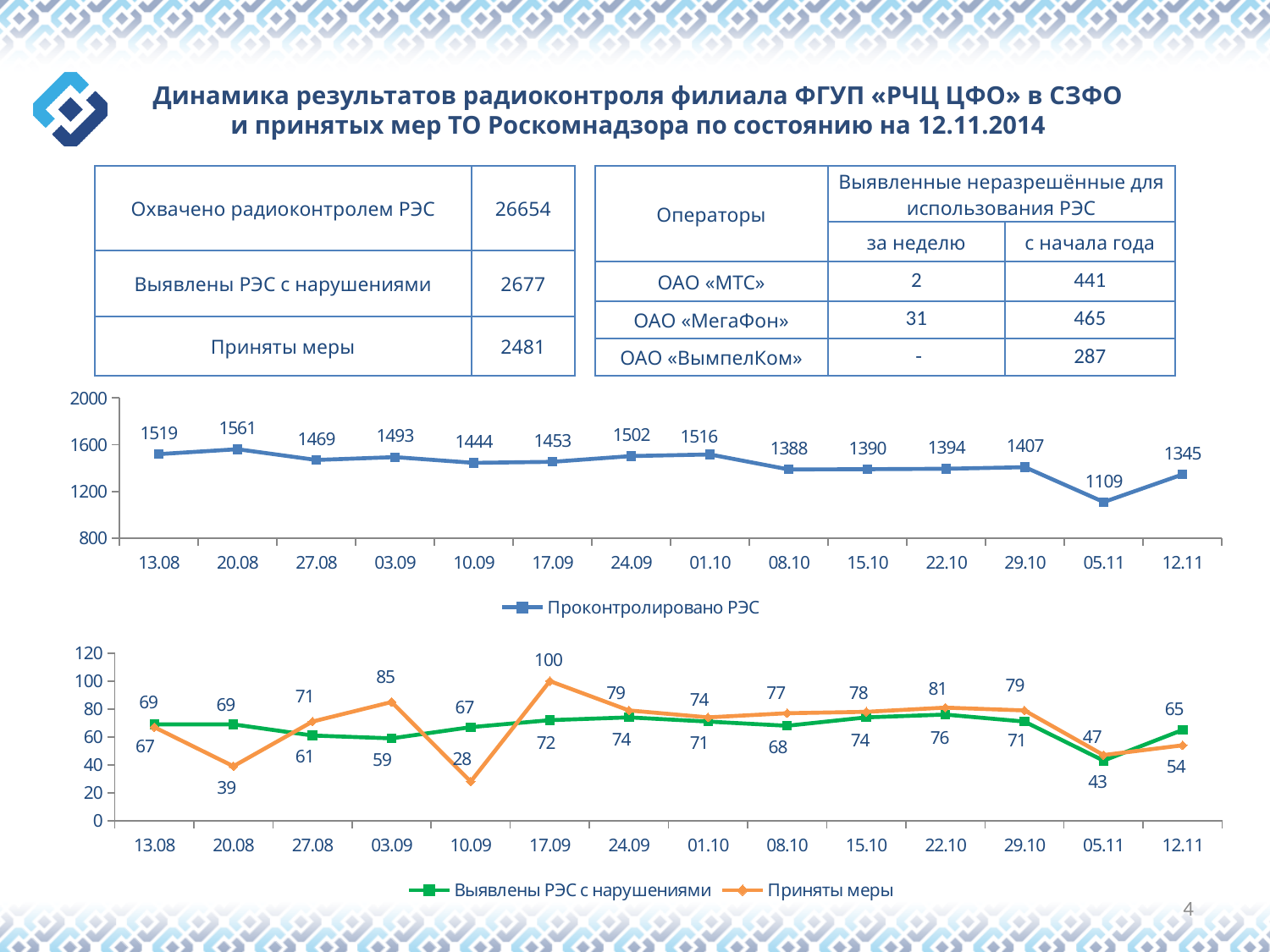
In the bottom chart, what is the difference between Приняты меры and Выявлены РЭС с нарушениями for 20.08? 30 In the bottom chart, which is larger for 03.09: Выявлены РЭС с нарушениями or Приняты меры? Приняты меры In the top chart (Проконтролировано РЭС), what is the difference between the values for 29.10 and 05.11? 298 How many series does the legend of the bottom chart list? 2 In the top chart (Проконтролировано РЭС), which date has the highest value? 20.08 In the bottom chart, what is the value of Приняты меры for 17.09? 100 In the top chart (Проконтролировано РЭС), what is the value for 20.08? 1561 In the top chart (Проконтролировано РЭС), how many data points are plotted? 14 In the top chart (Проконтролировано РЭС), which date has the lowest value? 05.11 In the bottom chart, what is the value of Выявлены РЭС с нарушениями for 05.11? 43 What type of chart is the top chart (Проконтролировано РЭС)? Line chart In the bottom chart, on which date is Приняты меры lowest? 10.09